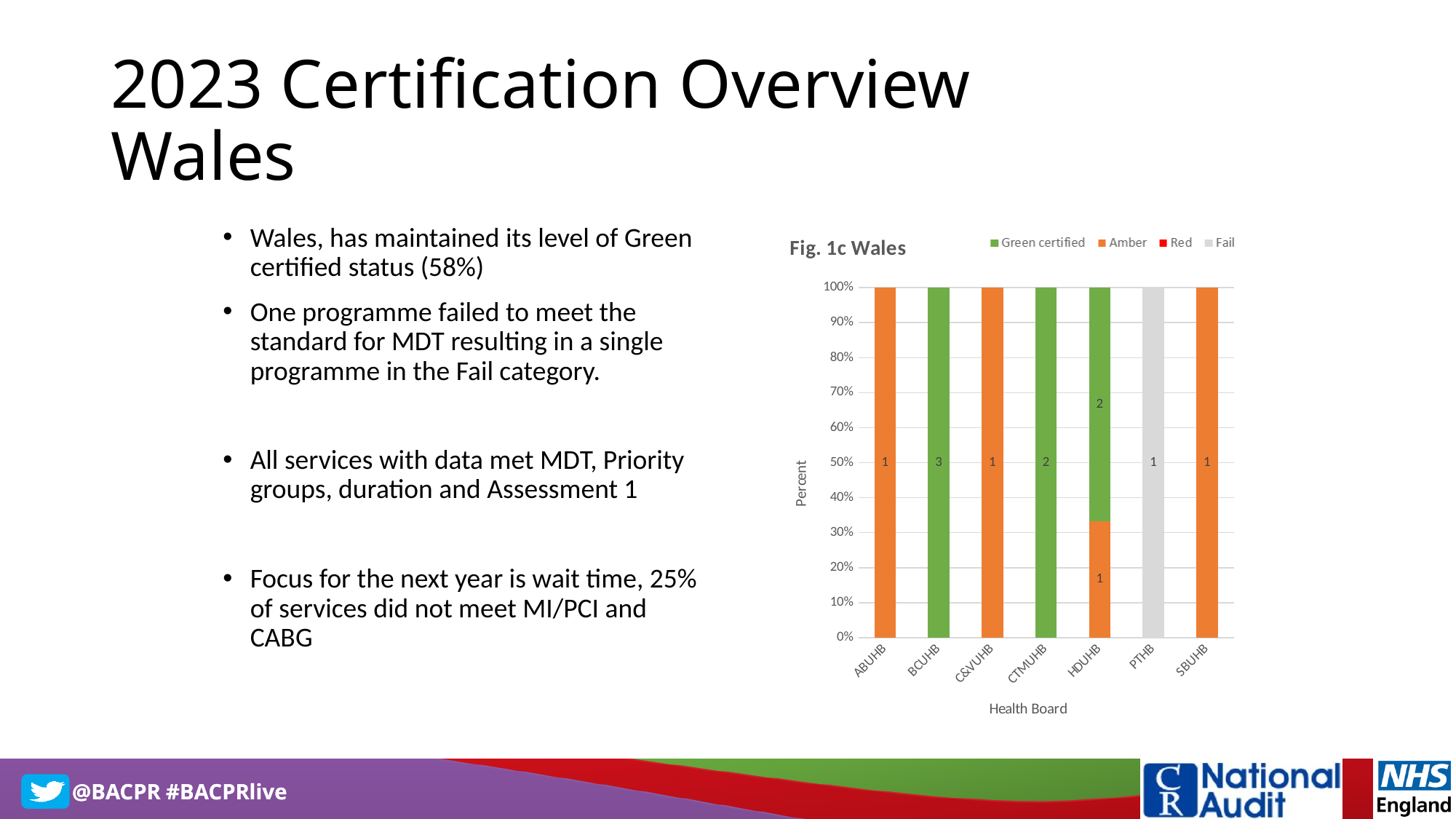
What is the data label on the Green certified bar for CTMUHB? 2 How many series does the legend of Fig. 1c Wales list? 4 What is the data label on the Green certified bar for BCUHB? 3 What is the data label on the Green certified segment for HDUHB? 2 How many health boards are shown on the x axis of Fig. 1c Wales? 7 What type of chart is Fig. 1c Wales? bar chart Which health board has the most Green certified programmes? BCUHB What is the total number of programmes labelled in the HDUHB bar? 3 What is the data label on the Amber segment for HDUHB? 1 Which health board's bar is shown entirely in the Fail colour? PTHB Is the Amber share of the HDUHB bar greater or less than 40%? less What is the data label on the Fail bar for PTHB? 1